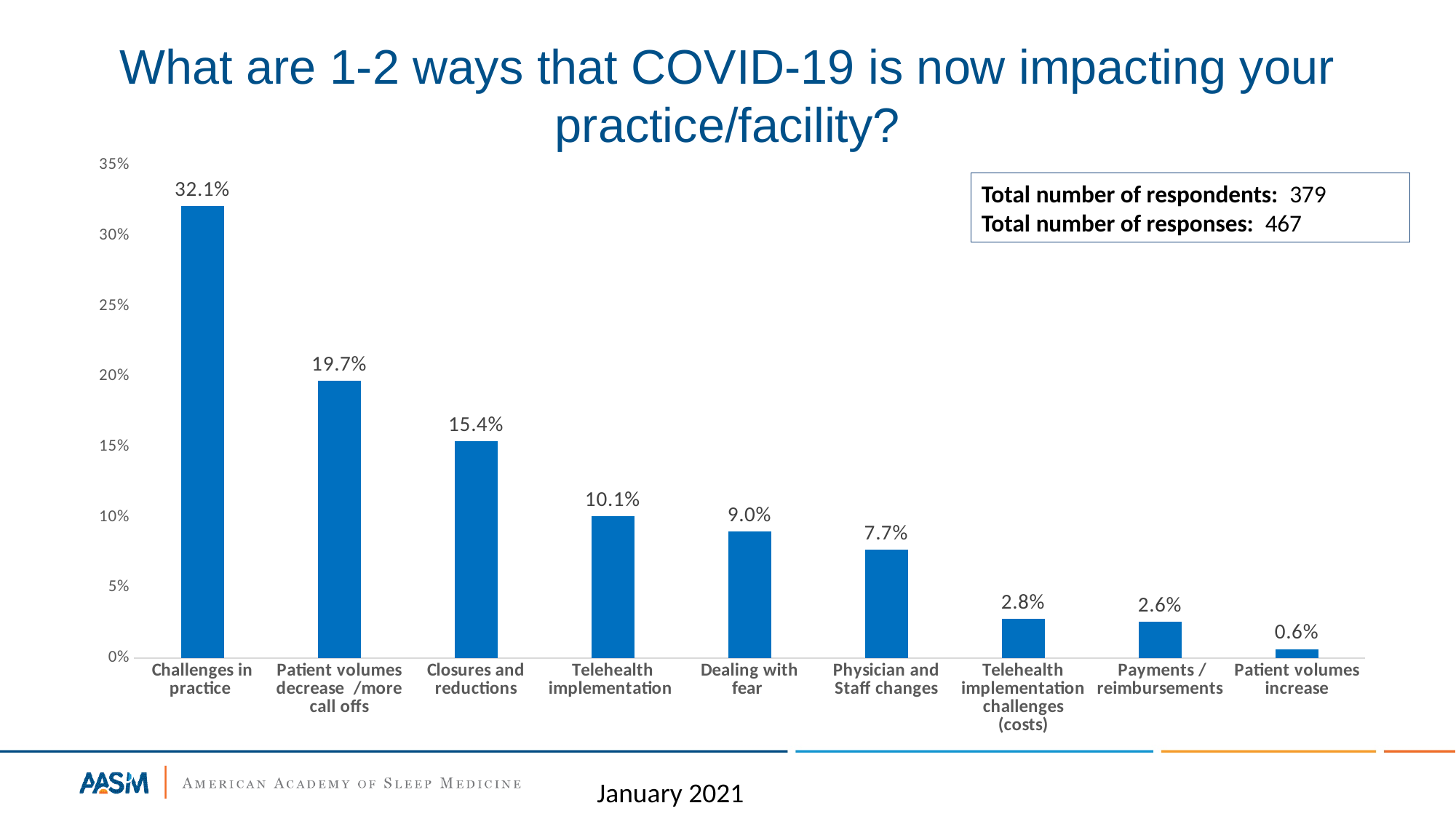
What is the total number of respondents stated on the slide? 379 What percentage is shown for Payments / reimbursements? 2.6% What is the difference between Challenges in practice and Patient volumes decrease /more call offs? 12.4% How many categories are shown on the chart? 9 Which category has the highest value? Challenges in practice What kind of chart is shown on the slide? Bar chart What percentage is shown for Challenges in practice? 32.1% Is the value for Closures and reductions greater or less than 15%? greater Which is larger, Dealing with fear or Physician and Staff changes? Dealing with fear Which category has the lowest value? Patient volumes increase Do the values rise or fall from left to right along the x axis? Fall What percentage is shown for Telehealth implementation? 10.1%